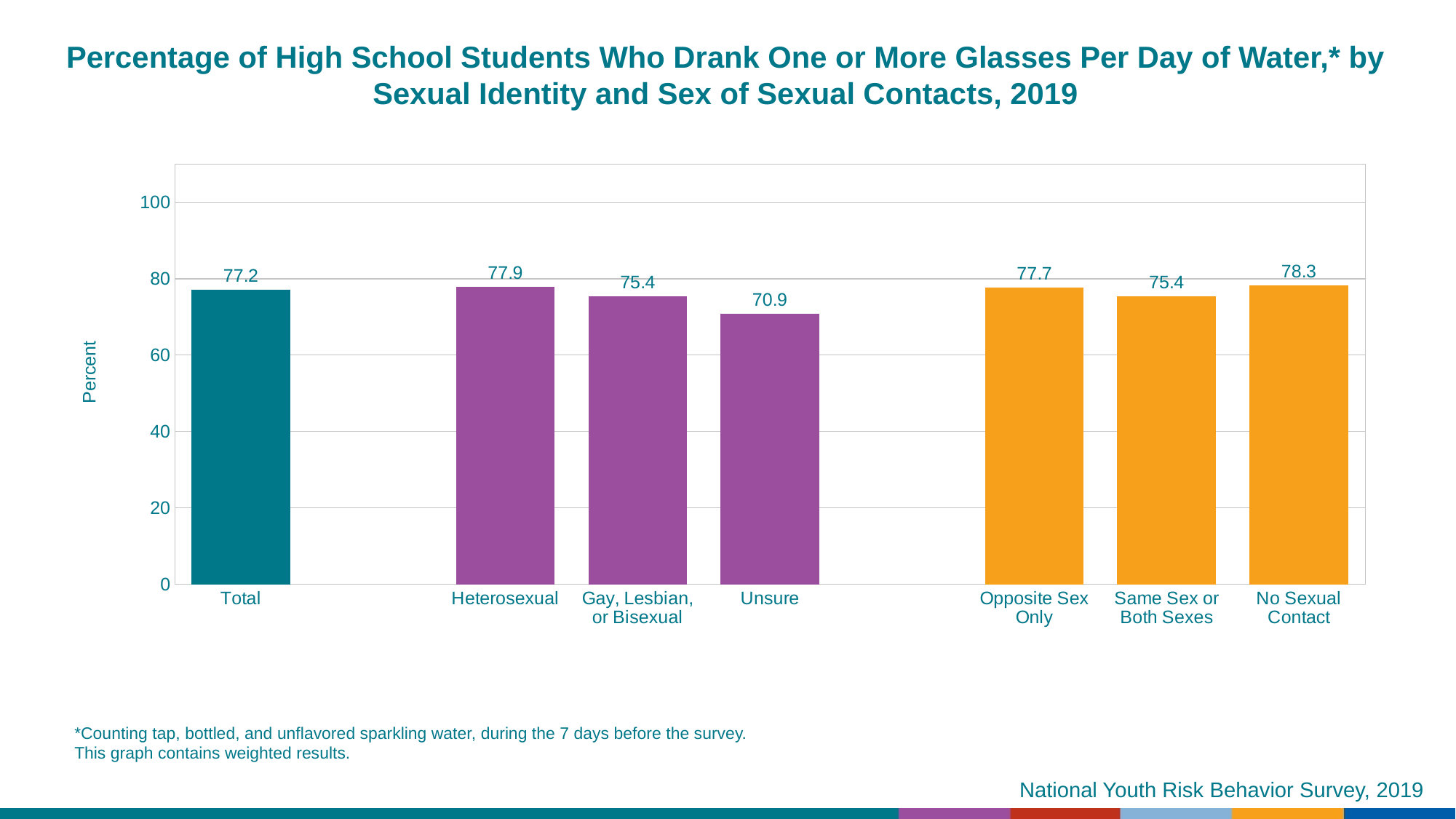
Which is larger, the value for Heterosexual or the value for Gay, Lesbian, or Bisexual? Heterosexual Which category has the lowest value? Unsure What is the difference between the values for Heterosexual and Unsure? 7.0 What kind of chart is this? bar chart What is the value for No Sexual Contact? 78.3 What is the difference between the values for No Sexual Contact and Same Sex or Both Sexes? 2.9 Is the value for Unsure greater or less than 80? less What is the value for Unsure? 70.9 Which category has the highest value? No Sexual Contact What is the value for Opposite Sex Only? 77.7 What is the value for Total? 77.2 How many bars are shown in the chart? 7